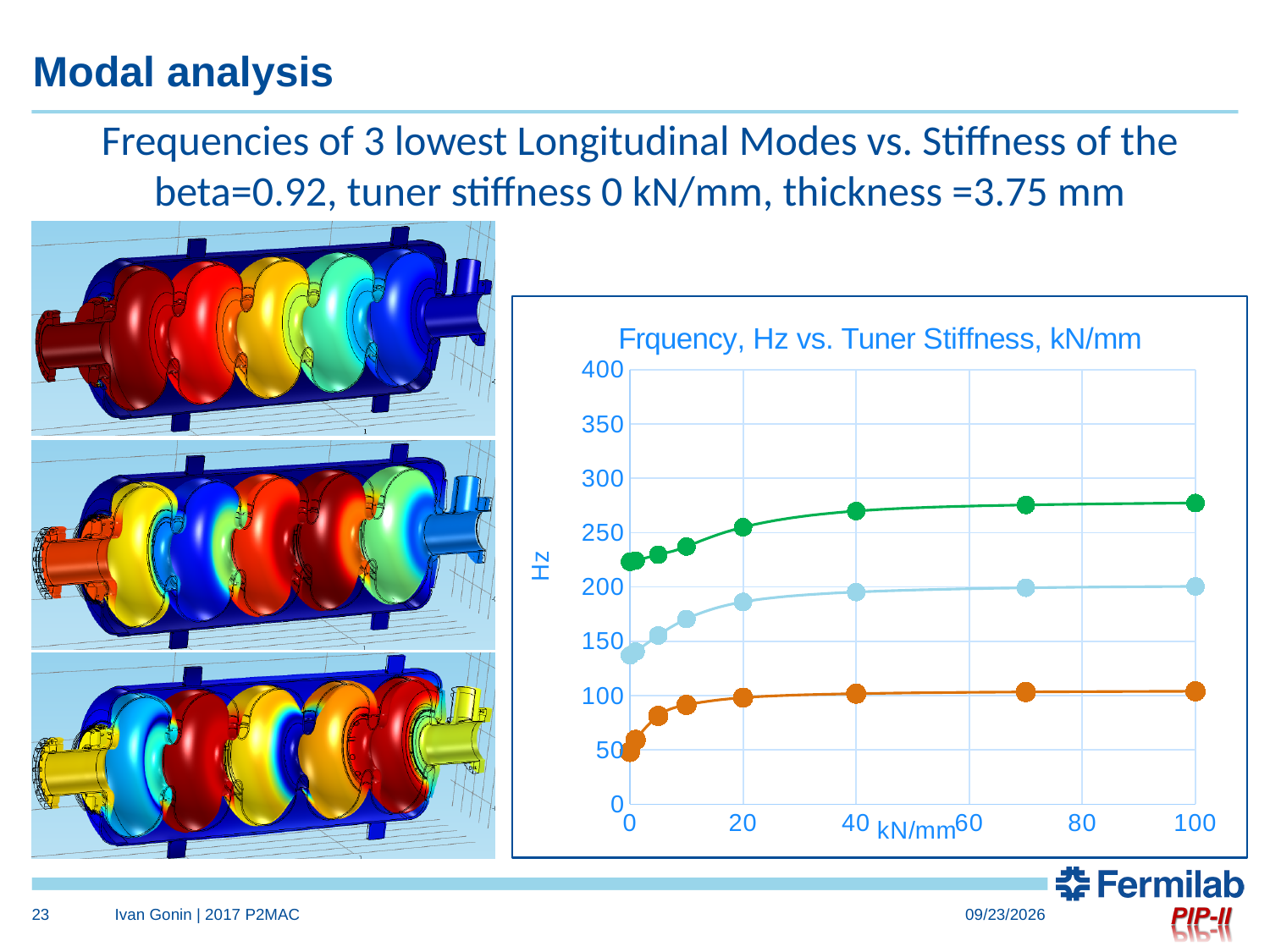
Which series has the highest frequency values across the whole x axis: green, light blue or orange? green Is the value of the green series at a tuner stiffness of 100 kN/mm greater or less than 250? greater Which series has the lowest frequency values across the whole x axis: green, light blue or orange? orange Is the value of the light blue series at a tuner stiffness of 0 kN/mm greater or less than 150? less At a tuner stiffness of 100 kN/mm, which series has the larger value, green or orange? green Is the value of the green series at a tuner stiffness of 100 kN/mm greater or less than 300? less What kind of chart is shown on the slide? line chart How many series (lines) are plotted on the chart? 3 Do the values of the green series rise or fall as tuner stiffness increases along the x axis? rise Do the values of the orange series rise or fall as tuner stiffness increases along the x axis? rise What is the label on the y axis of the chart? Hz What is the title of the chart? Frquency, Hz vs. Tuner Stiffness, kN/mm